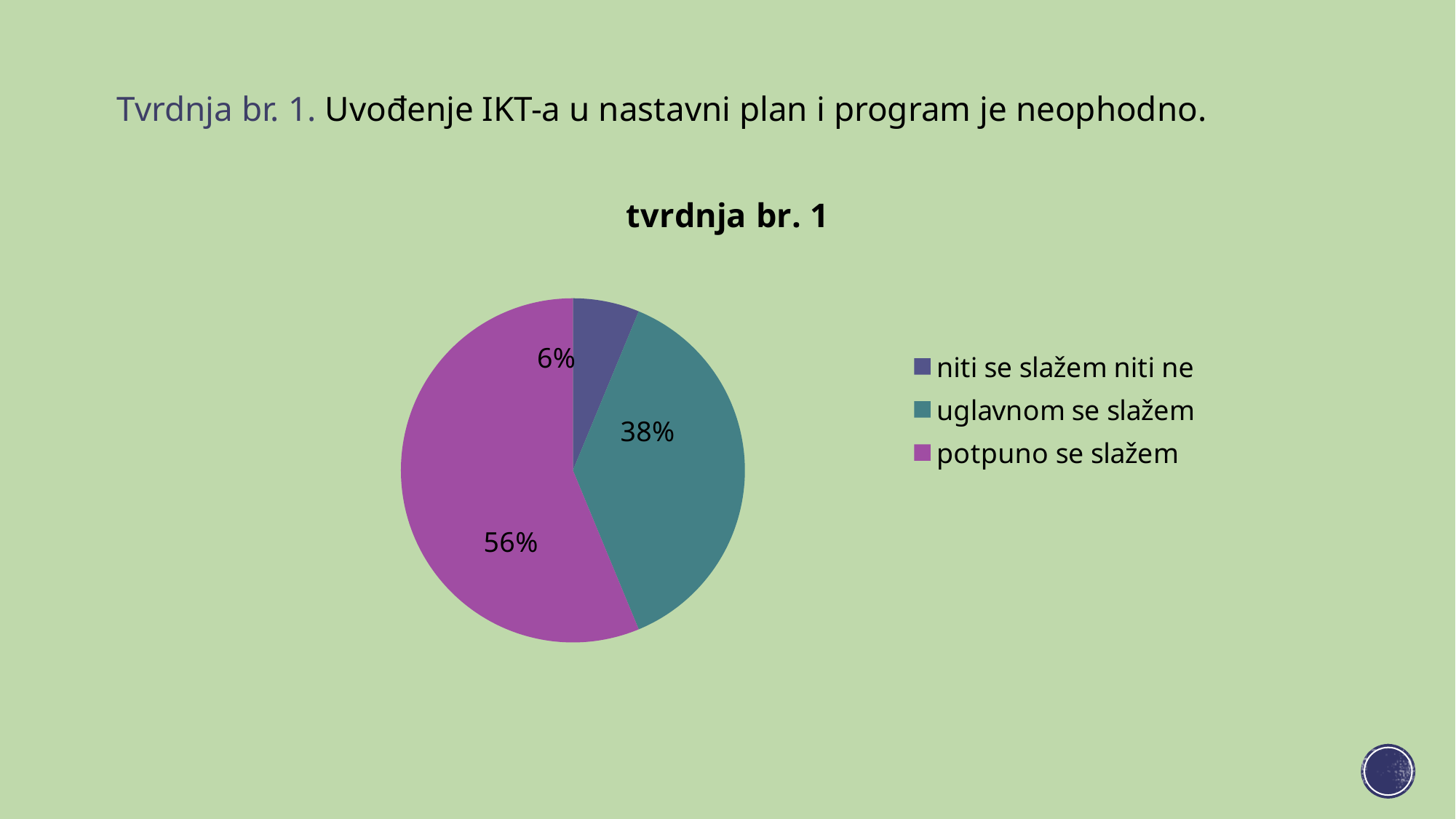
What is the chart's title? tvrdnja br. 1 What is the difference between the shares of 'potpuno se slažem' and 'uglavnom se slažem'? 18% What share of the pie is 'uglavnom se slažem'? 38% Which category has the largest slice? potpuno se slažem What is the difference between the shares of 'uglavnom se slažem' and 'niti se slažem niti ne'? 32% What colour is the slice for 'uglavnom se slažem'? teal What kind of chart is shown on the slide? pie chart How many categories does the legend list? 3 What share of the pie is 'niti se slažem niti ne'? 6% Which category has the smallest slice? niti se slažem niti ne Which is larger, the share for 'uglavnom se slažem' or for 'niti se slažem niti ne'? uglavnom se slažem What share of the pie is 'potpuno se slažem'? 56%